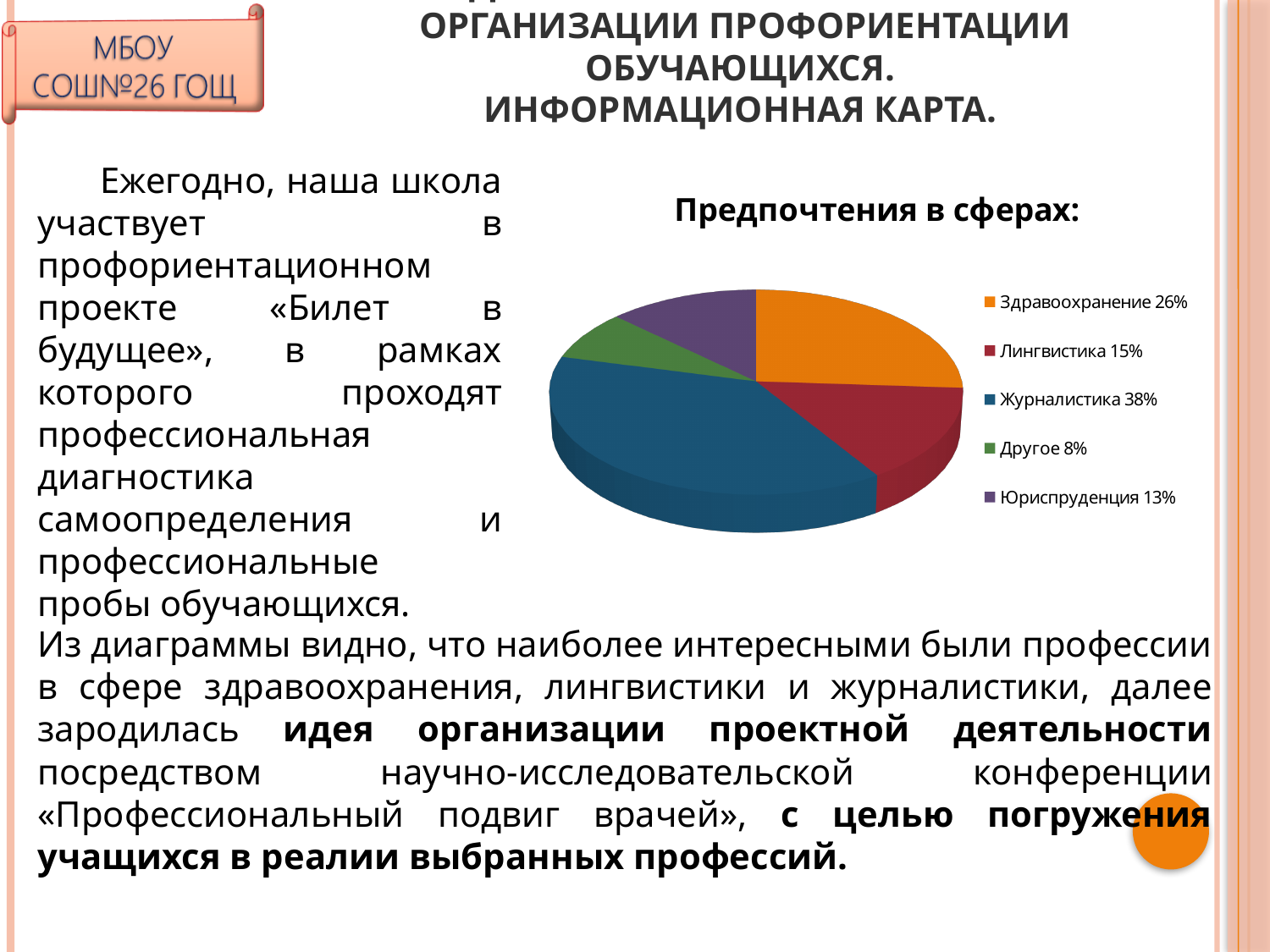
Which colour represents Здравоохранение in the pie chart? orange What share of the pie does Юриспруденция have? 13% What kind of chart is shown on the slide? pie chart What share of the pie does Журналистика have? 38% Which category has the smallest share of the pie? Другое What is the difference between the shares of Лингвистика and Другое? 7% What is the title of the chart? Предпочтения в сферах: What is the difference between the shares of Журналистика and Здравоохранение? 12% Which category has the largest share of the pie? Журналистика What share of the pie does Здравоохранение have? 26% Which is larger, the share of Лингвистика or the share of Юриспруденция? Лингвистика How many slices does the pie chart have? 5